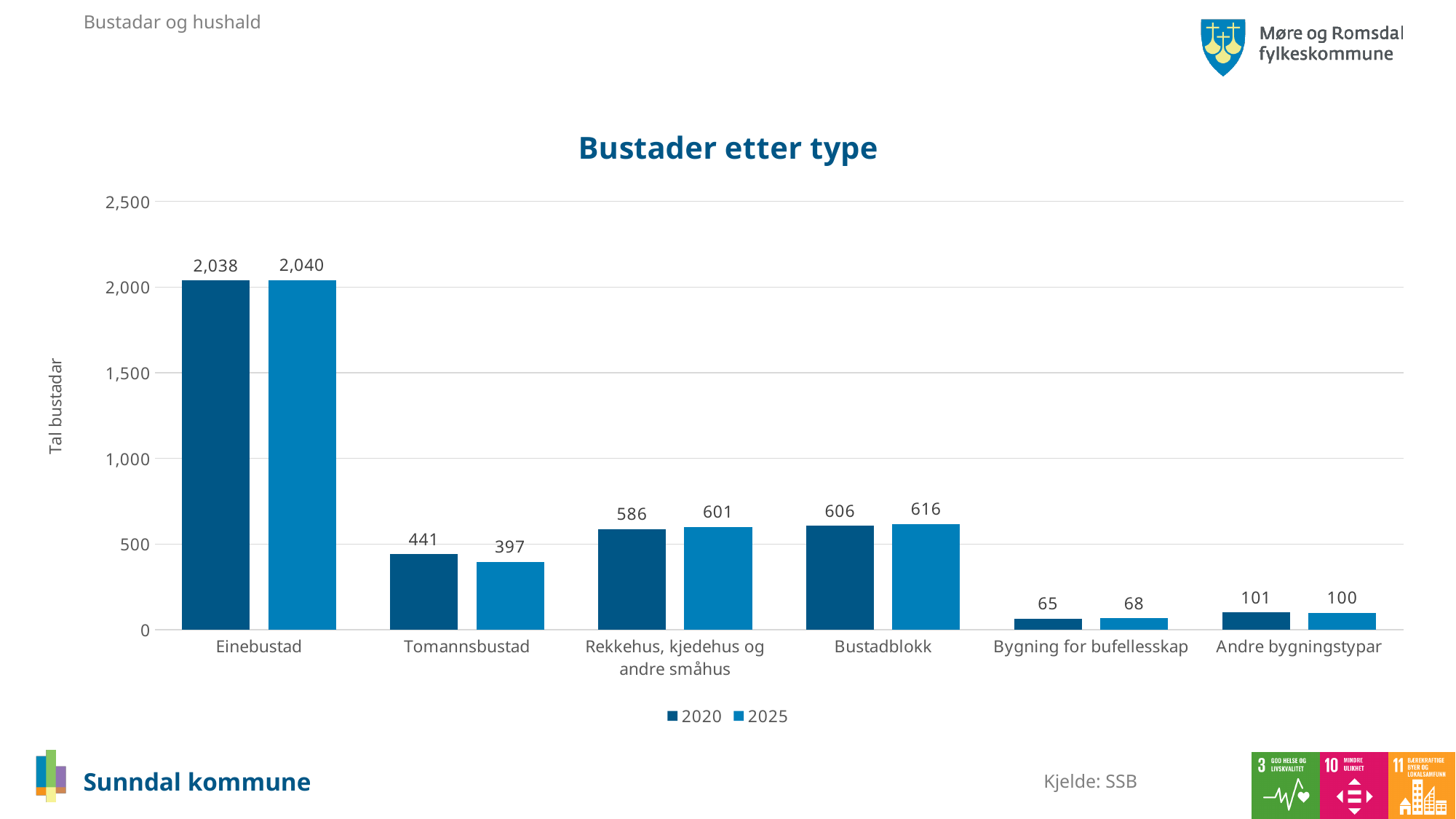
How many categories are shown on the x axis? 6 What is the value for Tomannsbustad in 2020? 441 What is the value for Einebustad in 2025? 2,040 What kind of chart is shown on the slide? Bar chart What is the value for Bygning for bufellesskap in 2020? 65 What is the value for Bustadblokk in 2025? 616 What is the title of the chart? Bustader etter type What is the difference between the 2020 and 2025 values for Tomannsbustad? 44 Which category has the lowest value in 2025? Bygning for bufellesskap Which category has the highest value in 2020? Einebustad Which is larger for Rekkehus, kjedehus og andre småhus: the 2020 value or the 2025 value? 2025 How many series does the legend list? 2